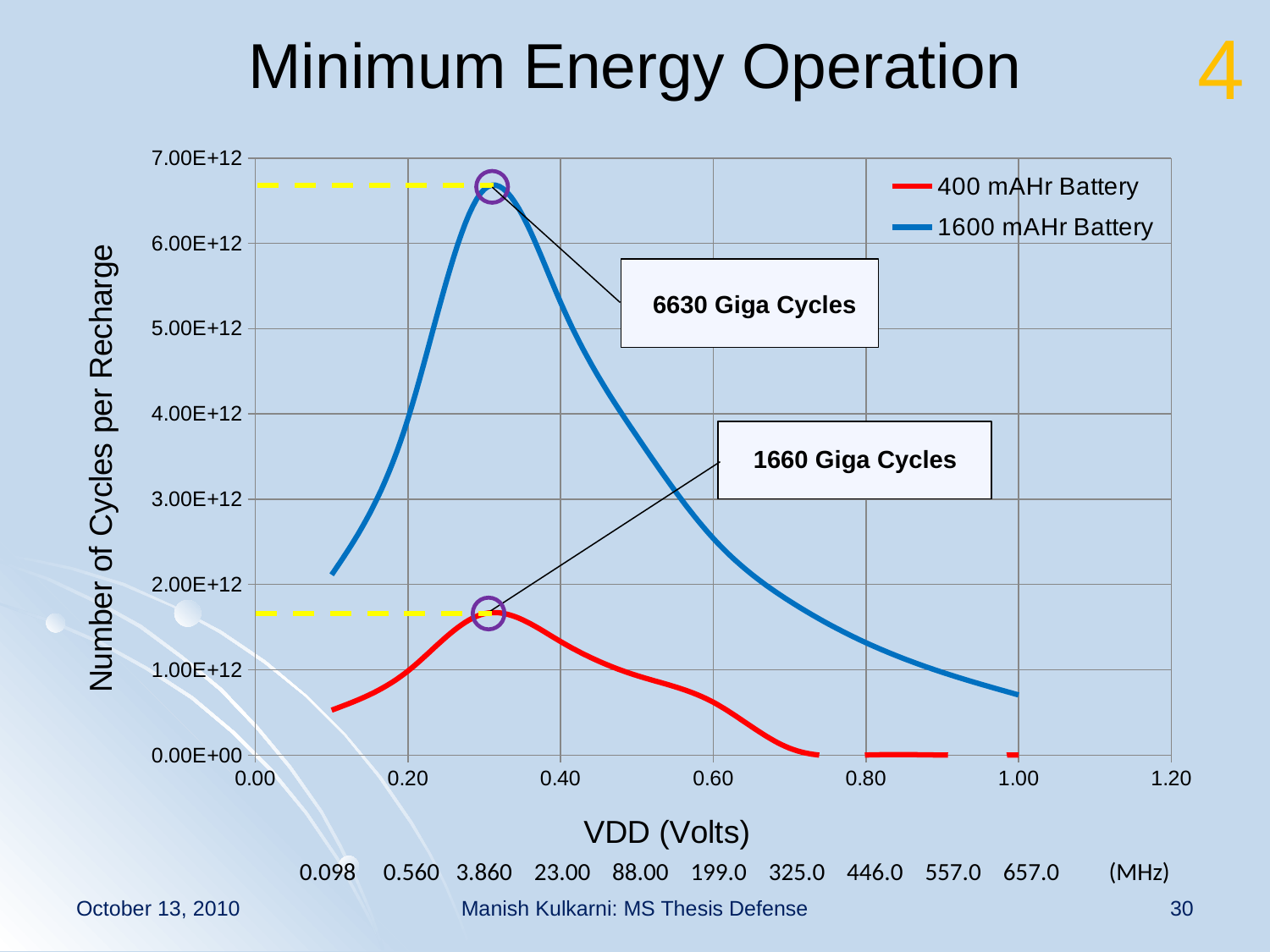
What is the peak number of cycles per recharge annotated for the 400 mAHr Battery? 1660 Giga Cycles What is the title of the x axis? VDD (Volts) Is the value for the 400 mAHr Battery at VDD 0.80 greater or less than 1.00E+12? less Does the 1600 mAHr Battery curve rise or fall as VDD increases from 0.40 to 1.00? fall What kind of chart is shown on the slide? line chart Is the value for the 400 mAHr Battery at VDD 0.40 greater or less than 1.00E+12? greater What are the two series named in the legend? 400 mAHr Battery and 1600 mAHr Battery What is the difference between the annotated peak values of the 1600 mAHr Battery and the 400 mAHr Battery? 4970 Giga Cycles How many series does the legend list? 2 Which series reaches the higher peak, the 400 mAHr Battery or the 1600 mAHr Battery? 1600 mAHr Battery Is the value for the 1600 mAHr Battery at VDD 0.80 greater or less than 2.00E+12? less What is the peak number of cycles per recharge annotated for the 1600 mAHr Battery? 6630 Giga Cycles